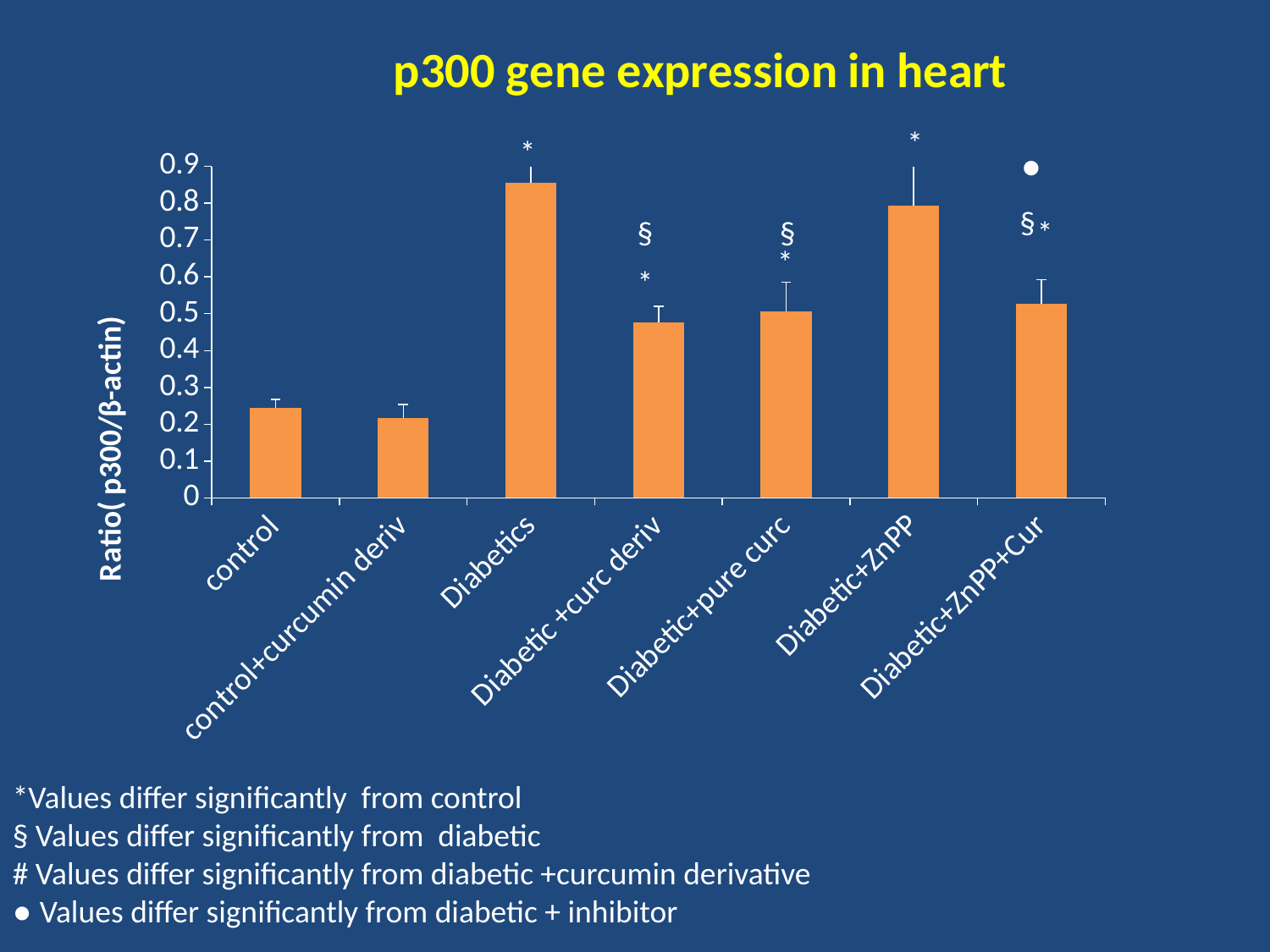
What kind of chart is shown on the slide? bar chart Which is larger, the value for control or the value for Diabetic+pure curc? Diabetic+pure curc Is the value for Diabetic+ZnPP+Cur greater or less than 0.4? greater Is the value for Diabetics greater or less than 0.8? greater What is the title of the chart? p300 gene expression in heart What is the label of the y axis? Ratio( p300/β-actin) Is the value for Diabetic +curc deriv greater or less than 0.6? less How many categories are shown on the x axis? 7 Which category has the highest value? Diabetics Which is larger, the value for Diabetics or the value for Diabetic+ZnPP? Diabetics